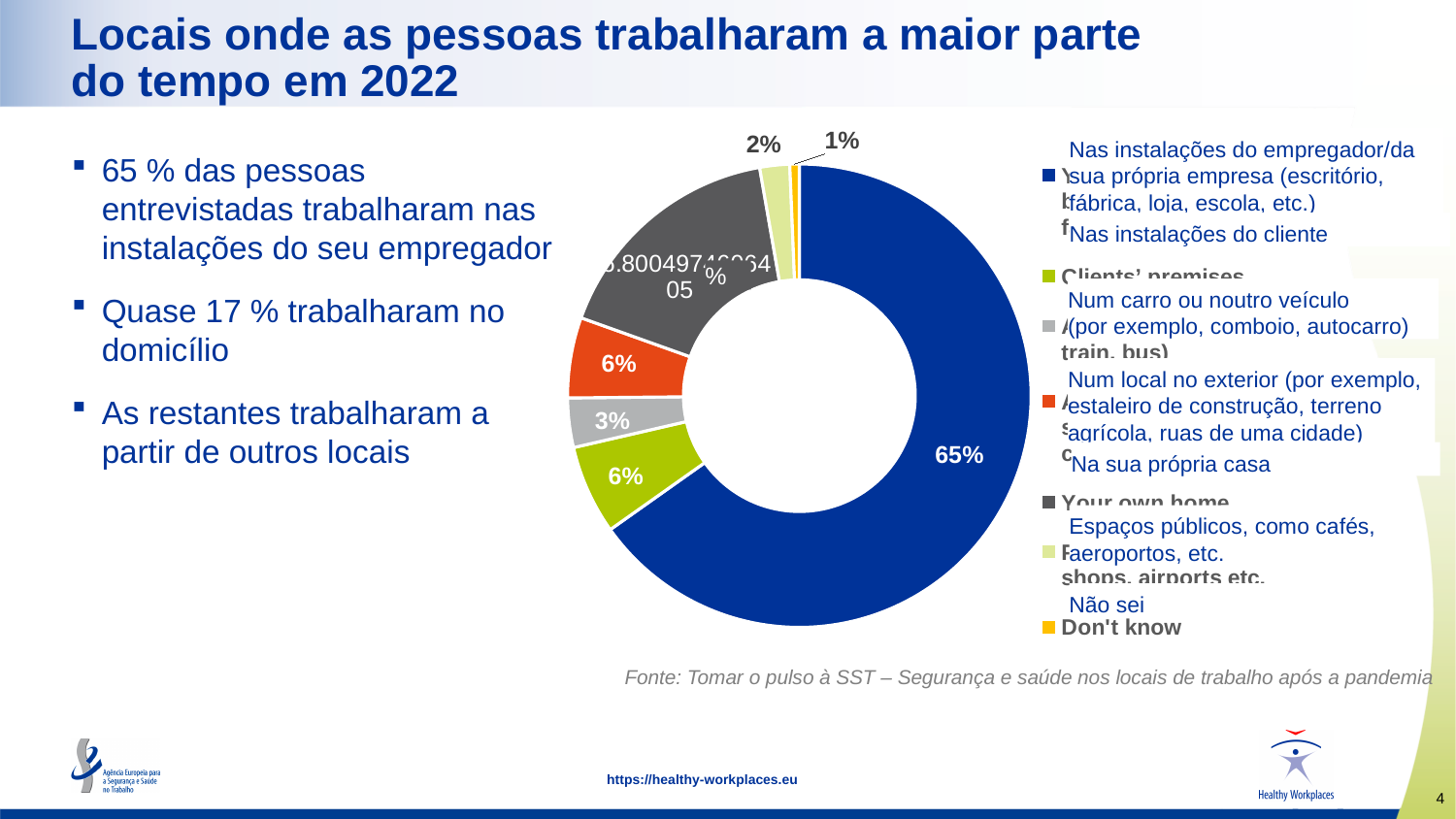
What percentage does the chart show for 'Nas instalações do cliente' (clients' premises)? 6% Which is larger: the slice for 'Num carro ou noutro veículo' or the slice for 'Espaços públicos'? Num carro ou noutro veículo Which category has the largest slice in the chart? Nas instalações do empregador/da sua própria empresa (employer's premises) What percentage does the chart show for 'Num local no exterior' (an outdoor location)? 6% What percentage does the chart show for 'Num carro ou noutro veículo' (a car or other vehicle)? 3% How many categories does the chart legend list? 7 How many percentage points larger is the employer's premises slice than the clients' premises slice? 59 percentage points What percentage does the chart show for 'Não sei' (Don't know)? 1% What kind of chart is shown on the slide? doughnut (pie) chart Which category has the smallest slice in the chart? Não sei (Don't know) What percentage does the chart show for 'Espaços públicos, como cafés, aeroportos, etc.' (public spaces)? 2% What share of the chart is 'Nas instalações do empregador/da sua própria empresa' (employer's premises)? 65%